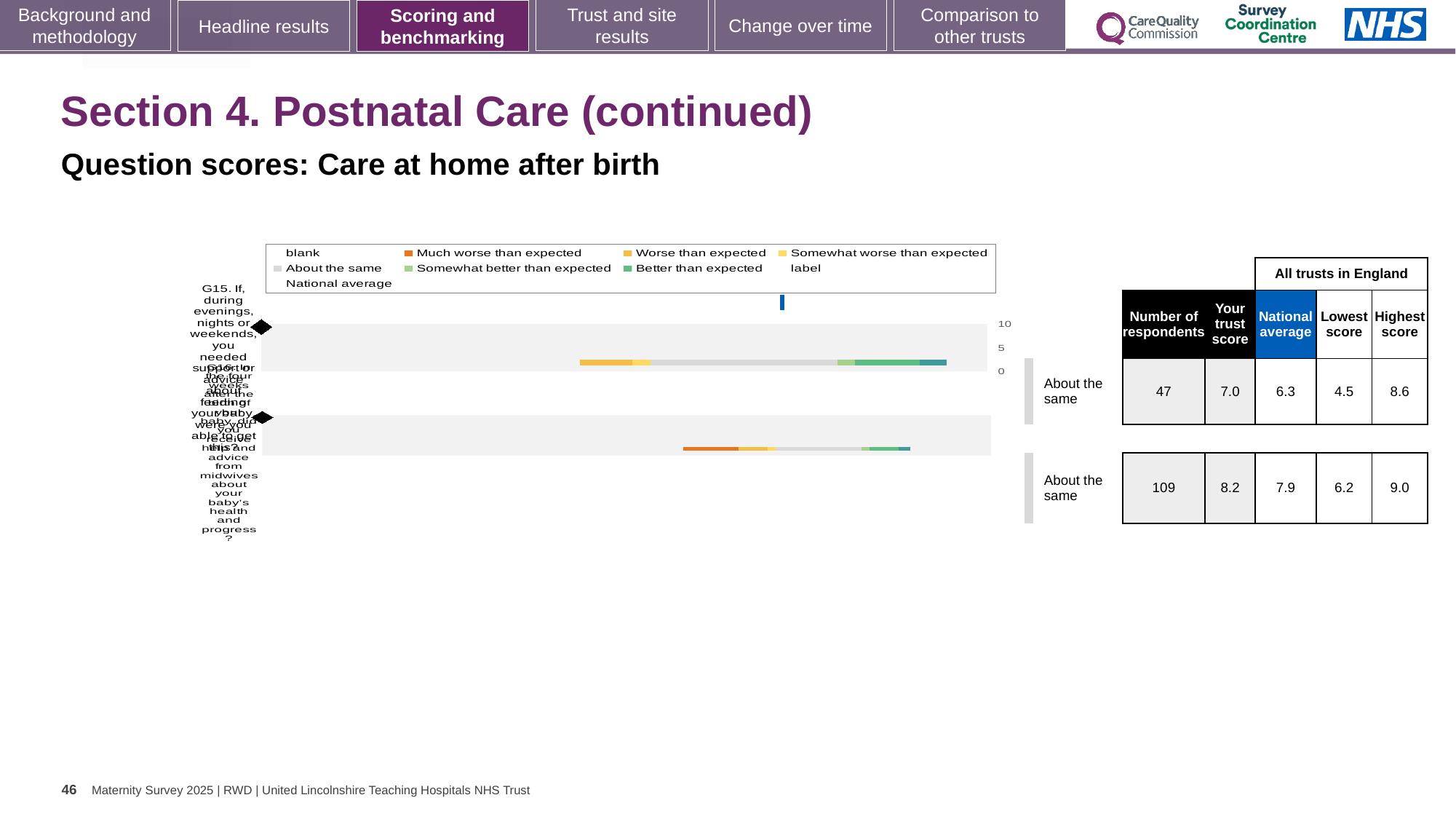
In the table beside the chart, what is the 'Your trust score' for the first row (47 respondents)? 7.0 In the table beside the chart, what is the Lowest score for the second row (109 respondents)? 6.2 In the table beside the chart, what is the National average for the second row (109 respondents)? 7.9 How many question bars are plotted in the chart? 2 What benchmark category is shown next to both bars in the chart? About the same How many entries does the chart legend list? 9 What kind of chart is shown on the slide? bar chart For the second row (109 respondents), what is the difference between the trust score and the National average? 0.3 In the table beside the chart, what is the Highest score for the first row (47 respondents)? 8.6 In the table beside the chart, how many respondents are listed for the second row? 109 Which row has the higher 'Your trust score': the first row (47 respondents) or the second row (109 respondents)? the second row (109 respondents) For the first row (47 respondents), what is the difference between the trust score and the National average? 0.7